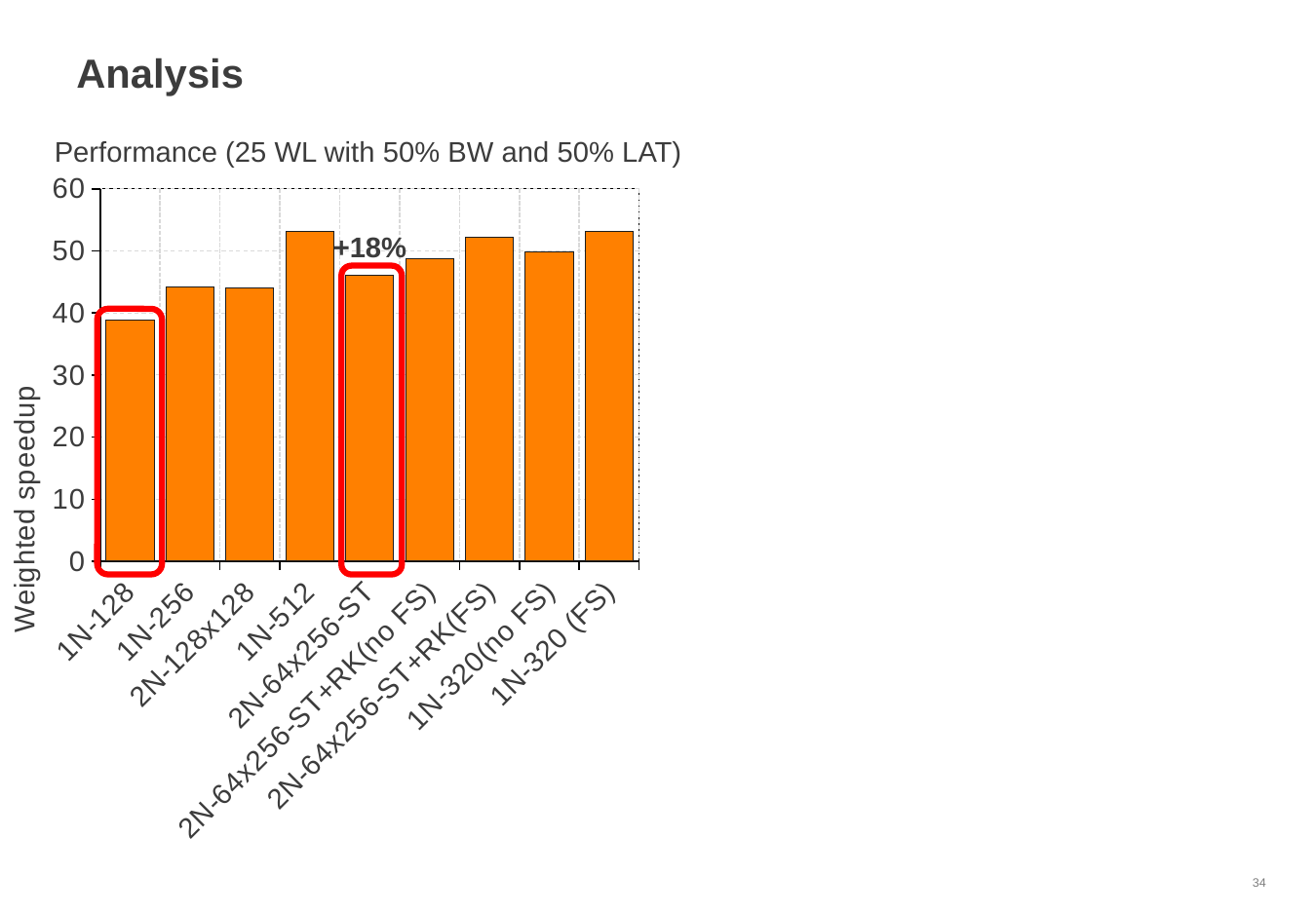
What is the title of the chart? Performance (25 WL with 50% BW and 50% LAT) Is the value for 1N-512 greater or less than 50? greater Which has a larger weighted speedup, 2N-64x256-ST+RK(FS) or 2N-64x256-ST? 2N-64x256-ST+RK(FS) Is the value for 1N-128 greater or less than 40? less What kind of chart is shown on the slide? bar chart Is the value for 2N-64x256-ST greater or less than 50? less Which category has the lowest weighted speedup? 1N-128 Which has a larger weighted speedup, 1N-512 or 1N-128? 1N-512 How many categories are plotted on the x axis of the chart? 9 What percentage annotation is printed above the 2N-64x256-ST bar? +18%